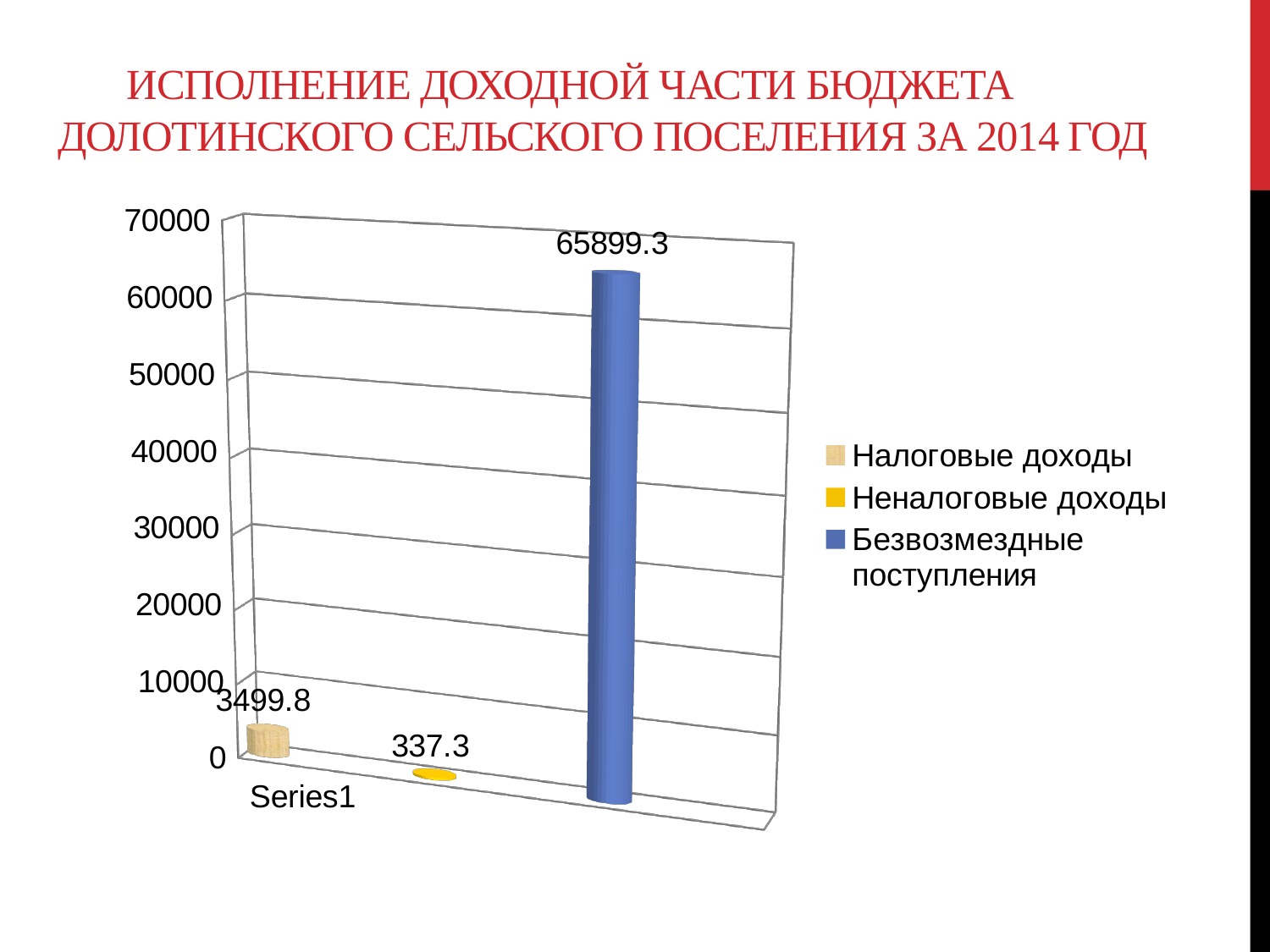
What is the value for Налоговые доходы? 3499.8 What is the difference between Налоговые доходы and Неналоговые доходы? 3162.5 What kind of chart is shown on the slide? Bar chart Is the value for Безвозмездные поступления greater or less than 60000? greater How many series does the legend list? 3 What is the value for Безвозмездные поступления? 65899.3 Which is larger, Налоговые доходы or Неналоговые доходы? Налоговые доходы What is the difference between Безвозмездные поступления and Налоговые доходы? 62399.5 Which series has the highest value? Безвозмездные поступления Which series has the lowest value? Неналоговые доходы What is the value for Неналоговые доходы? 337.3 What is the label of the category on the x axis? Series1